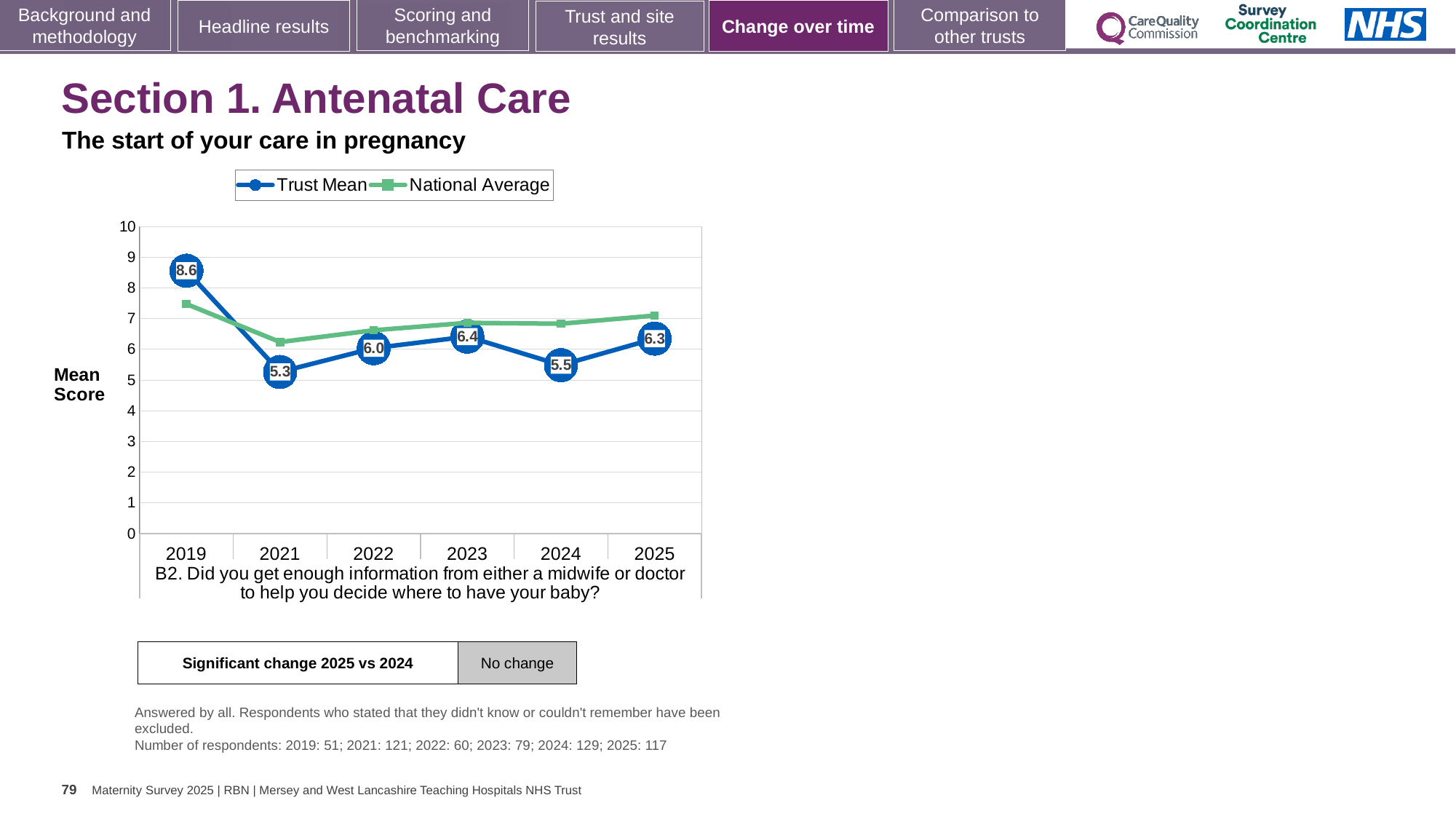
How many years are shown on the x axis? 6 What is the Trust Mean for 2024? 5.5 Which is larger, the Trust Mean in 2023 or in 2024? 2023 Is the National Average for 2021 greater or less than 7? less What kind of chart is shown on the slide? Line chart Is the National Average for 2019 greater or less than 7? greater What is the Trust Mean for 2025? 6.3 In which year is the Trust Mean lowest? 2021 What is the difference between the Trust Mean in 2019 and in 2021? 3.3 In which year is the Trust Mean highest? 2019 What is the Trust Mean for 2019? 8.6 How many series does the legend list? 2